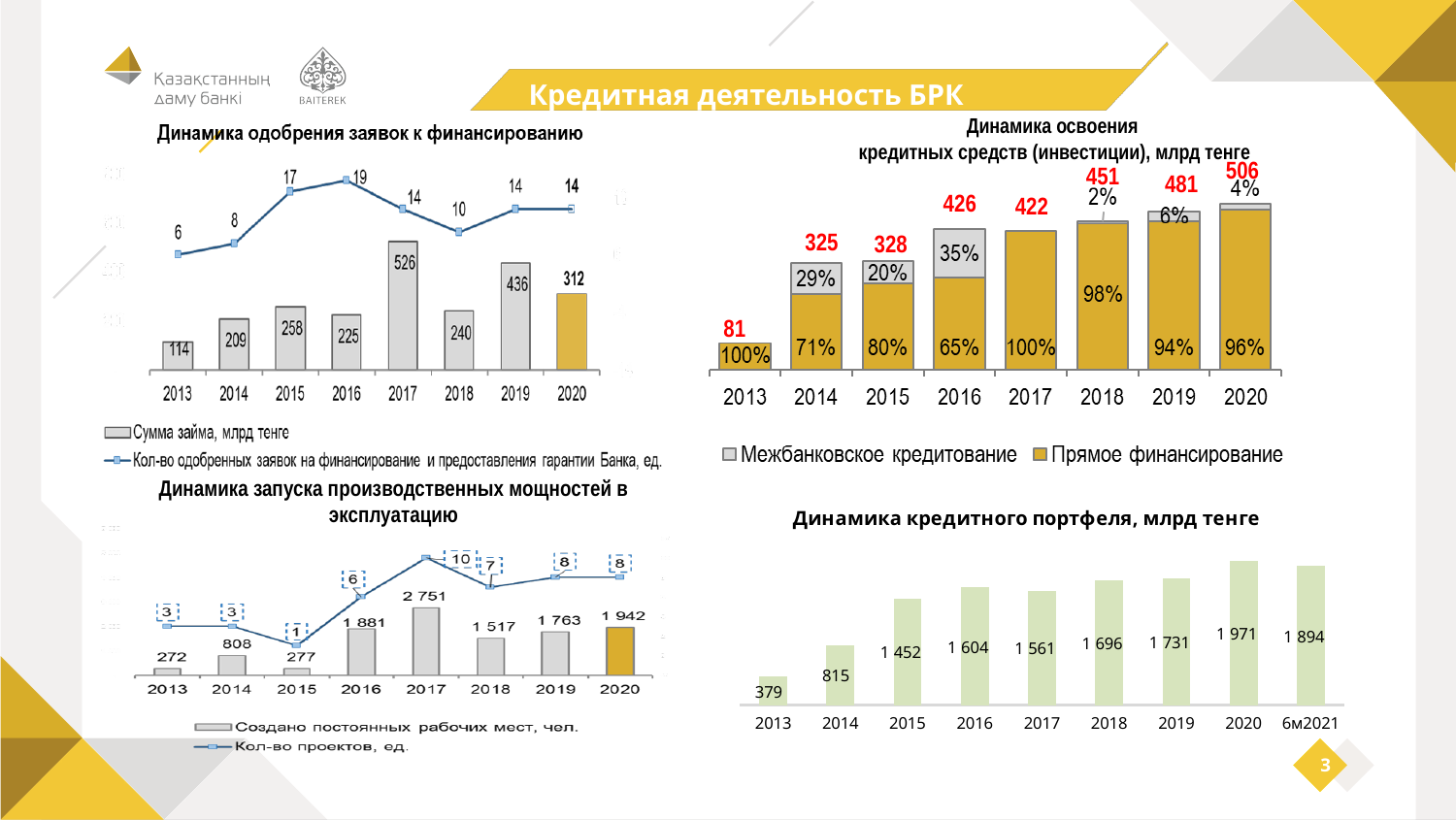
In the chart 'Динамика одобрения заявок к финансированию', what is the loan amount (Сумма займа) for 2017? 526 In the chart 'Динамика запуска производственных мощностей в эксплуатацию', which is larger: the number of jobs created in 2018 or in 2019? 2019 In the chart 'Динамика освоения кредитных средств (инвестиции), млрд тенге', what share of 2016 is Межбанковское кредитование? 35% In the chart 'Динамика освоения кредитных средств (инвестиции), млрд тенге', how many series does the legend list? 2 In the chart 'Динамика одобрения заявок к финансированию', which year has the highest loan amount (Сумма займа)? 2017 In the chart 'Динамика одобрения заявок к финансированию', what is the difference between the loan amounts for 2019 and 2020? 124 In the chart 'Динамика кредитного портфеля, млрд тенге', which year has the lowest value? 2013 In the chart 'Динамика кредитного портфеля, млрд тенге', what is the value for 2020? 1 971 In the chart 'Динамика запуска производственных мощностей в эксплуатацию', how many permanent jobs (Создано постоянных рабочих мест) were created in 2017? 2 751 In the chart 'Динамика освоения кредитных средств (инвестиции), млрд тенге', what is the total for 2018? 451 In the chart 'Динамика кредитного портфеля, млрд тенге', how many categories are shown on the x axis? 9 In the chart 'Динамика запуска производственных мощностей в эксплуатацию', what is the number of projects (Кол-во проектов) for 2015? 1